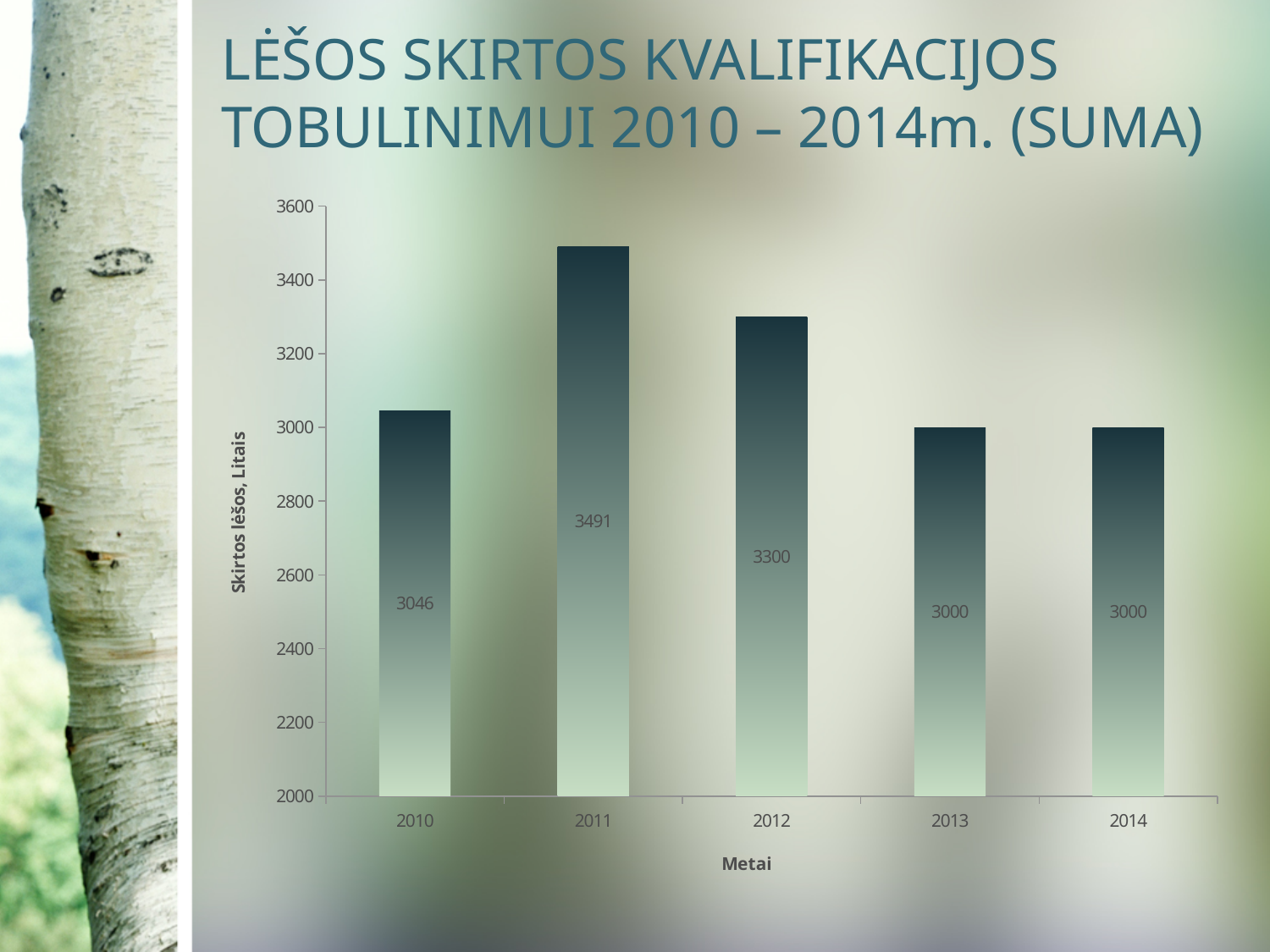
What is the label of the y axis? Skirtos lėšos, Litais How many years are shown on the x axis? 5 What is the value for 2011? 3491 Which year has the highest value? 2011 What is the value for 2012? 3300 Do the values rise or fall from 2011 to 2013? fall What kind of chart is shown on the slide? bar chart What is the difference between the values for 2011 and 2012? 191 What is the value for 2010? 3046 Is the value for 2011 greater or less than 3400? greater What is the difference between the values for 2010 and 2013? 46 Which is larger, the value for 2010 or the value for 2012? 2012